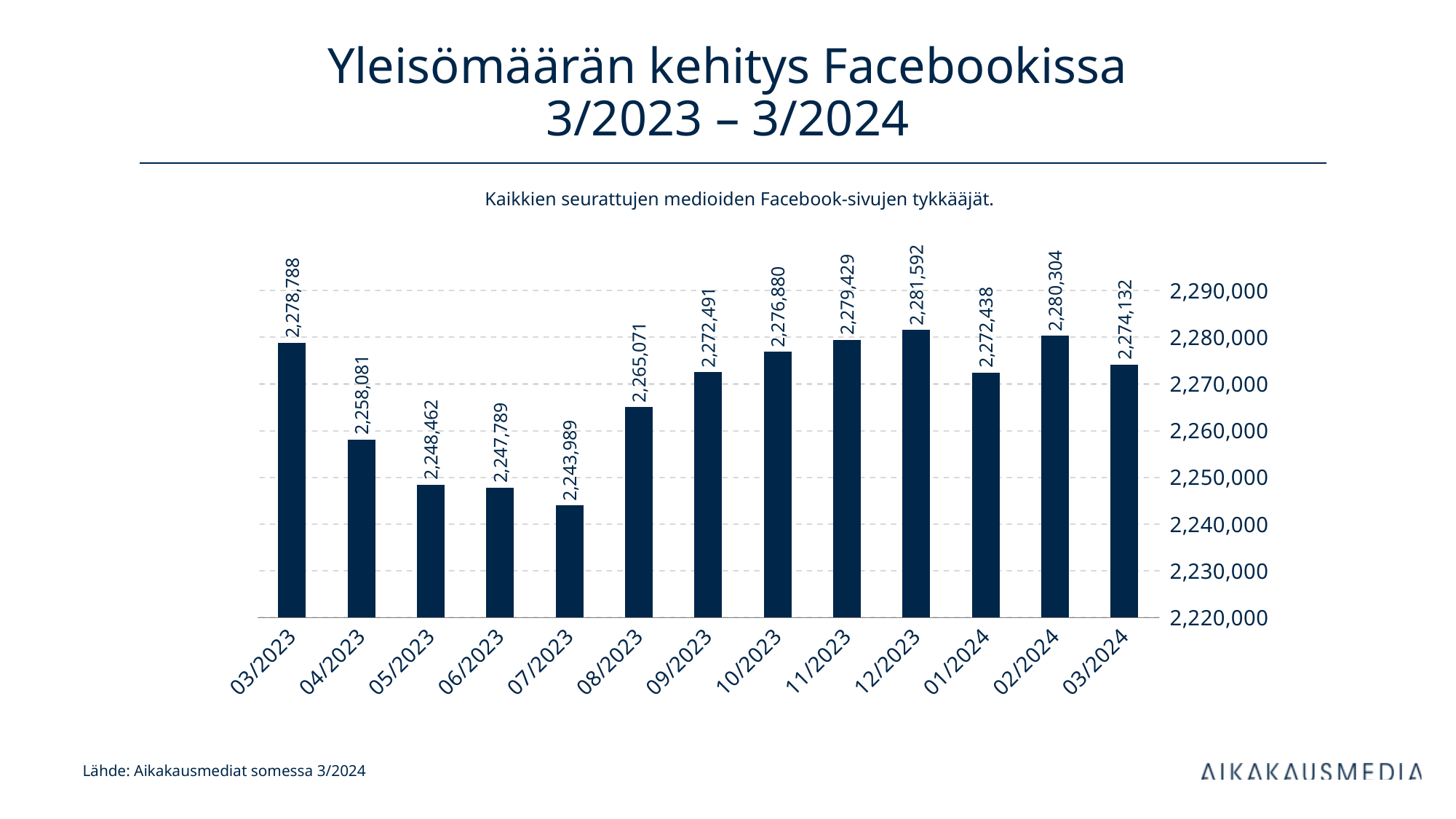
What is the difference between the values for 12/2023 and 07/2023? 37,603 What is the value for 03/2024? 2,274,132 What is the value for 07/2023? 2,243,989 Is the value for 05/2023 greater or less than 2,250,000? less Which month has the lowest value? 07/2023 What is the title of the chart? Yleisömäärän kehitys Facebookissa 3/2023 – 3/2024 Which month has the highest value? 12/2023 Do the values rise or fall from 07/2023 to 12/2023? rise How many months are shown on the x axis? 13 What is the value for 03/2023? 2,278,788 What kind of chart is shown on the slide? bar chart Which is larger, the value for 04/2023 or the value for 08/2023? 08/2023